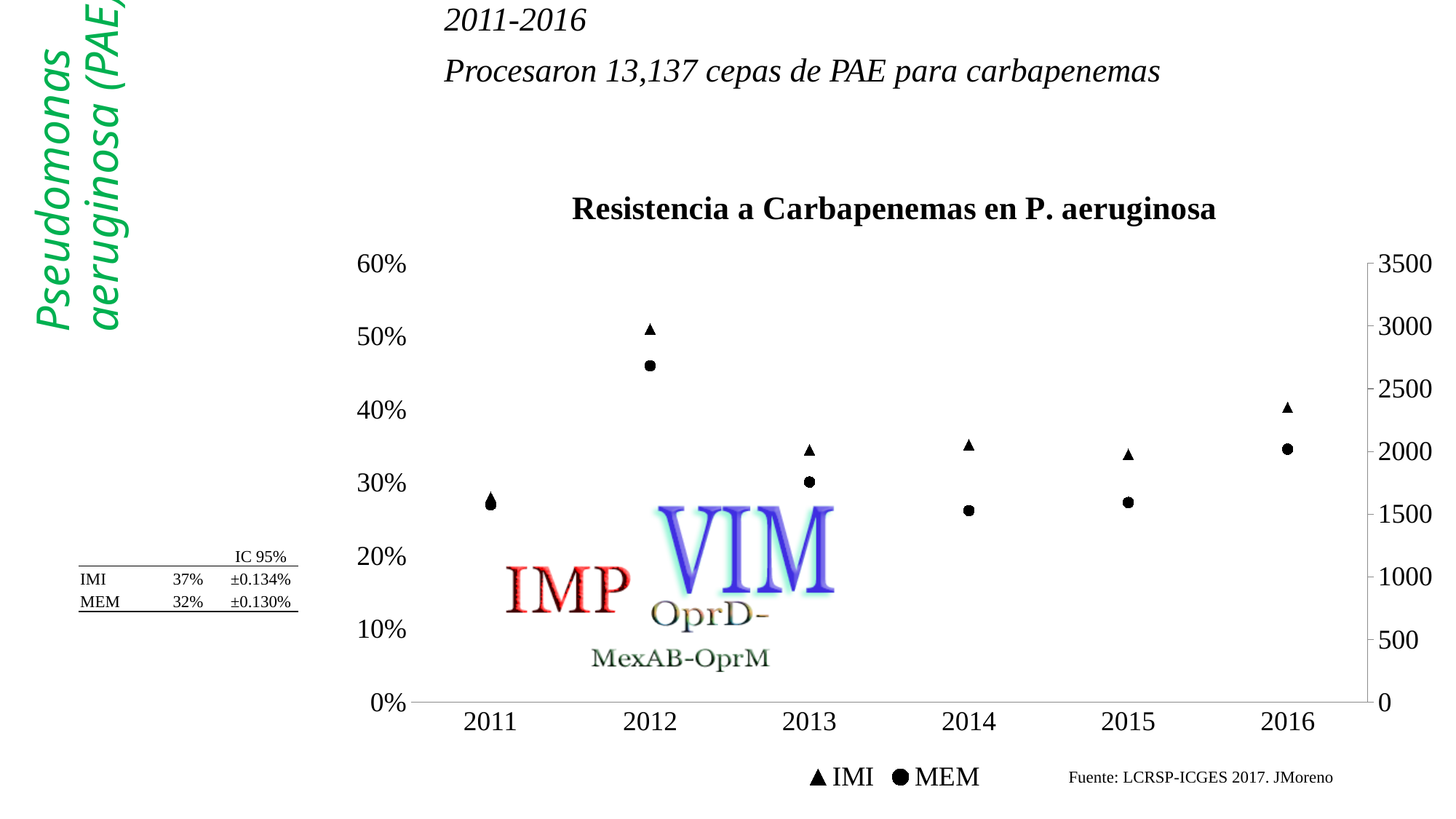
In which year is the IMI value highest? 2012 Is the MEM value for 2012 greater or less than 40%? greater How many series does the legend of the chart list? 2 Between 2011 and 2012, did the IMI value rise or fall? rise In which year is the IMI value lowest? 2011 What kind of chart is 'Resistencia a Carbapenemas en P. aeruginosa'? scatter chart Is the IMI value for 2016 greater or less than 30%? greater Is the MEM value for 2014 greater or less than 30%? less How many years are shown on the x axis of the chart? 6 In which year is the MEM value highest? 2012 In 2014, which series has the larger value, IMI or MEM? IMI Which marker shape represents the MEM series in the legend? circle